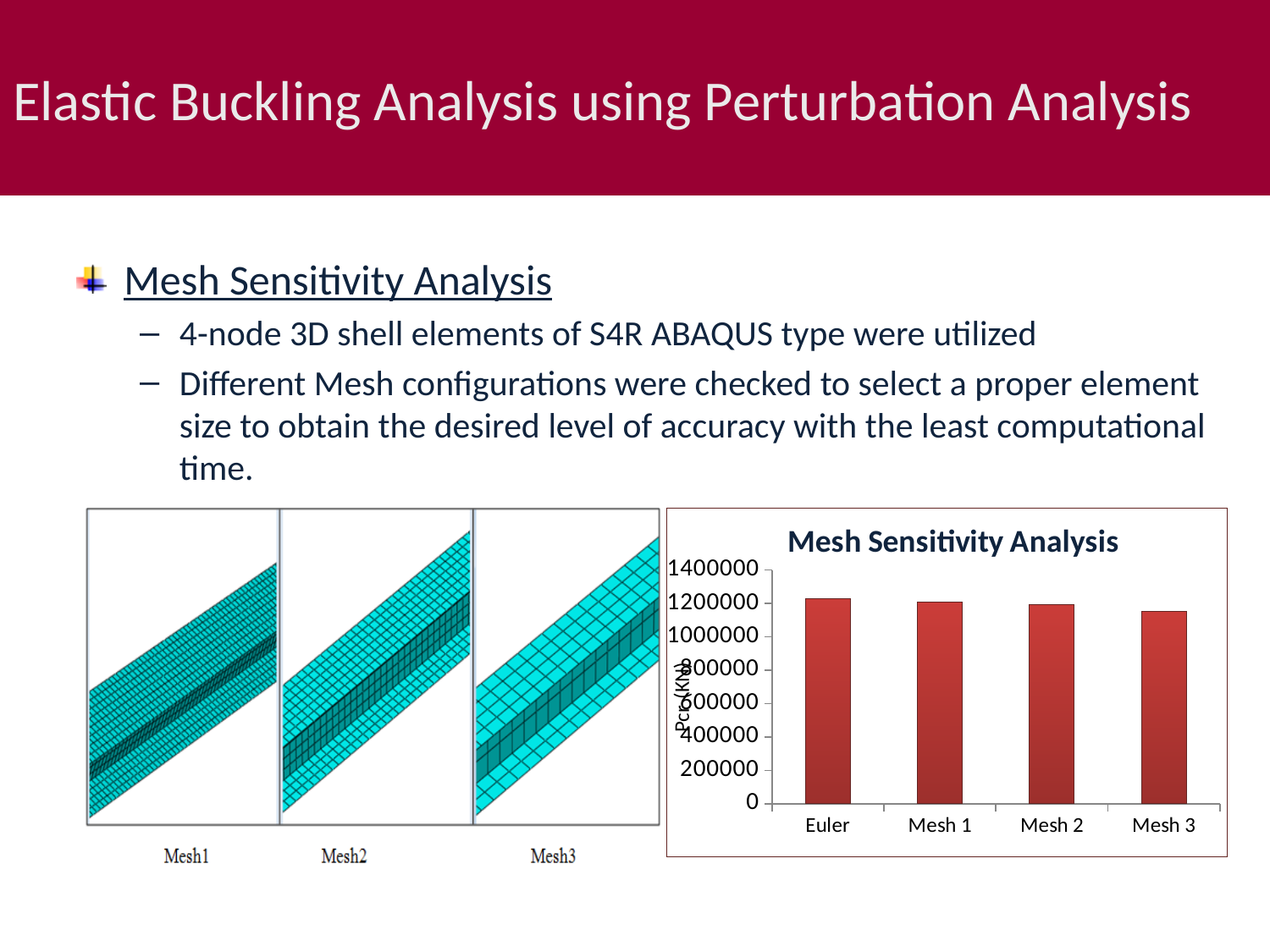
What is the title of the chart on the slide? Mesh Sensitivity Analysis In the Mesh Sensitivity Analysis chart, is the value for Mesh 3 greater or less than 1000000? greater Which category has the highest bar in the Mesh Sensitivity Analysis chart? Euler How many categories are plotted on the x axis of the Mesh Sensitivity Analysis chart? 4 What is the highest tick value shown on the y axis of the Mesh Sensitivity Analysis chart? 1400000 Which category has the lowest bar in the Mesh Sensitivity Analysis chart? Mesh 3 In the Mesh Sensitivity Analysis chart, is the value for Euler greater or less than 1400000? less Do the bar values in the Mesh Sensitivity Analysis chart rise or fall from Euler to Mesh 3? fall In the Mesh Sensitivity Analysis chart, which is larger, the value for Euler or the value for Mesh 3? Euler What kind of chart is shown under the title "Mesh Sensitivity Analysis"? bar chart In the Mesh Sensitivity Analysis chart, is the value for Mesh 1 greater or less than 800000? greater